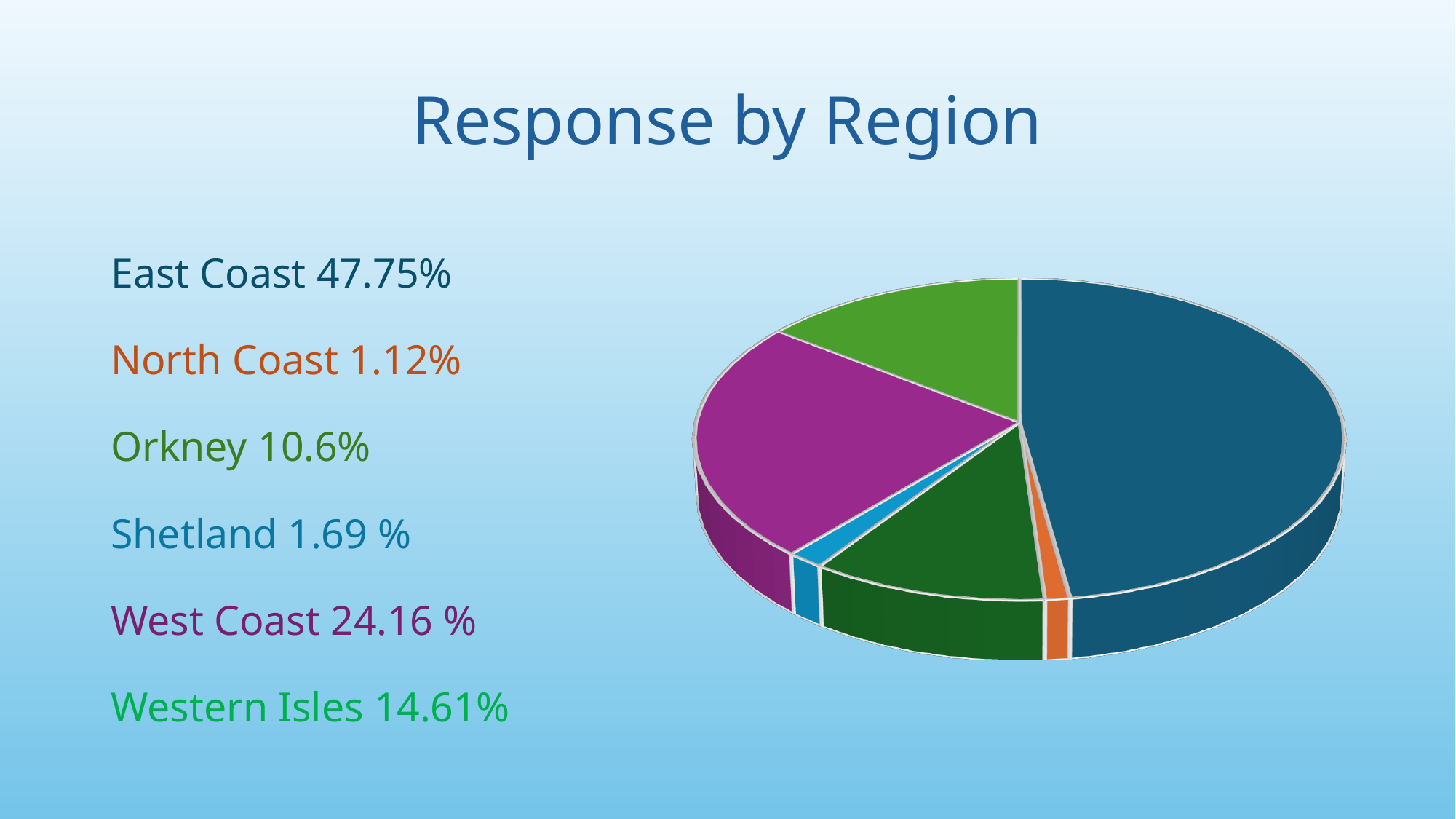
What is the title of the chart? Response by Region Which region has the smallest share of responses? North Coast How many regions are shown in the pie chart? 6 How many percentage points larger is the East Coast share than the West Coast share? 23.59 How many percentage points larger is the Western Isles share than the Orkney share? 4.01 What percentage of responses came from the East Coast? 47.75% What percentage of responses came from Orkney? 10.6% Which region has a larger share of responses, West Coast or Western Isles? West Coast What kind of chart is shown on the slide? pie chart What percentage of responses came from the Western Isles? 14.61% Which region has the largest share of responses? East Coast What percentage of responses came from Shetland? 1.69 %